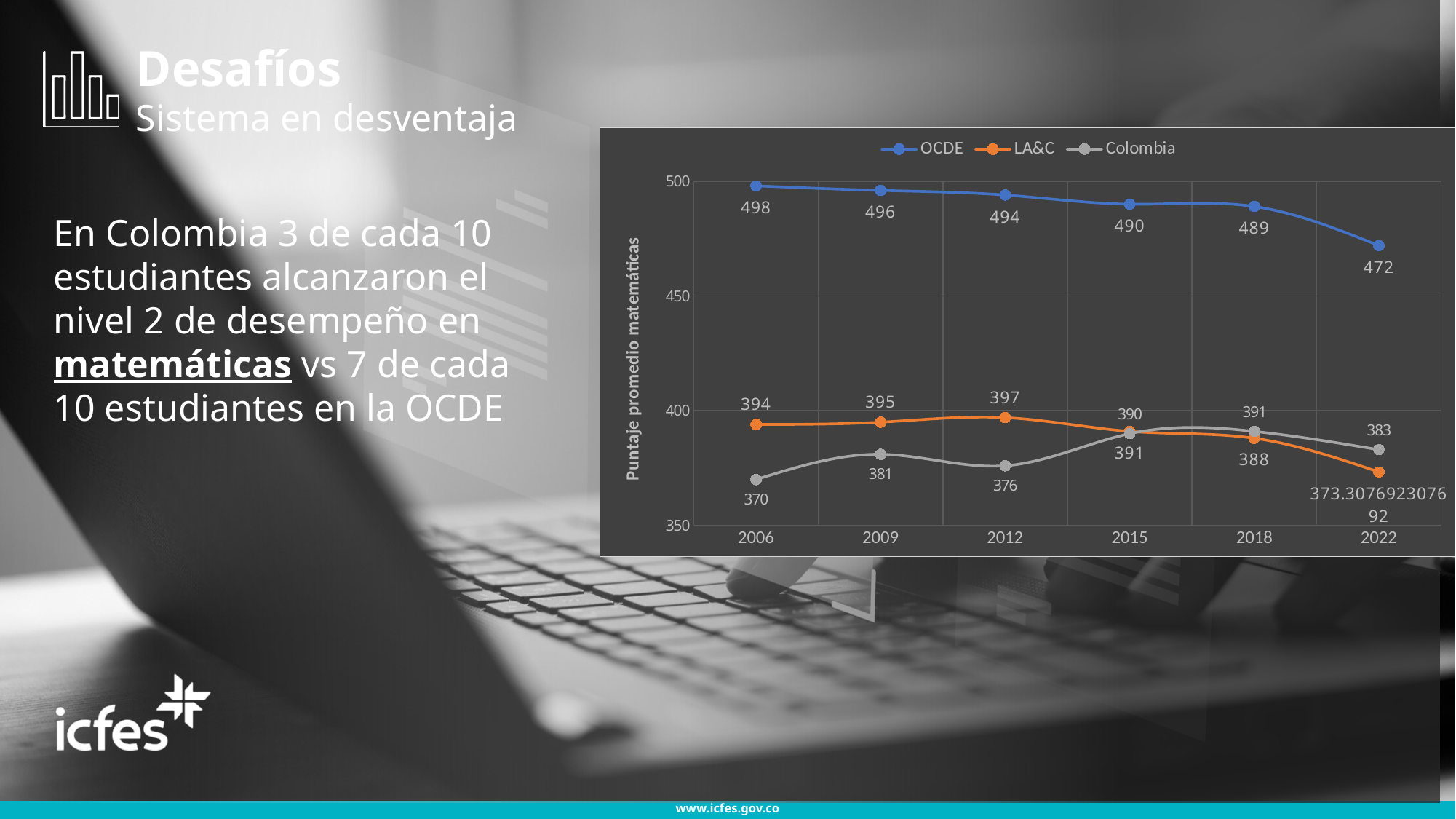
What is the difference between the OCDE value and the Colombia value in 2006? 128 How many years are plotted along the x axis? 6 What is the Colombia value for 2006? 370 Which is larger in 2018, the LA&C value or the Colombia value? Colombia How many series does the legend list? 3 What is the LA&C value for 2012? 397 In which year is the OCDE series highest? 2006 Does the OCDE series rise or fall from 2006 to 2022? fall In which year is the Colombia series lowest? 2006 What is the OCDE value for 2022? 472 What type of chart is shown on the slide? line chart What is the label of the vertical axis? Puntaje promedio matemáticas